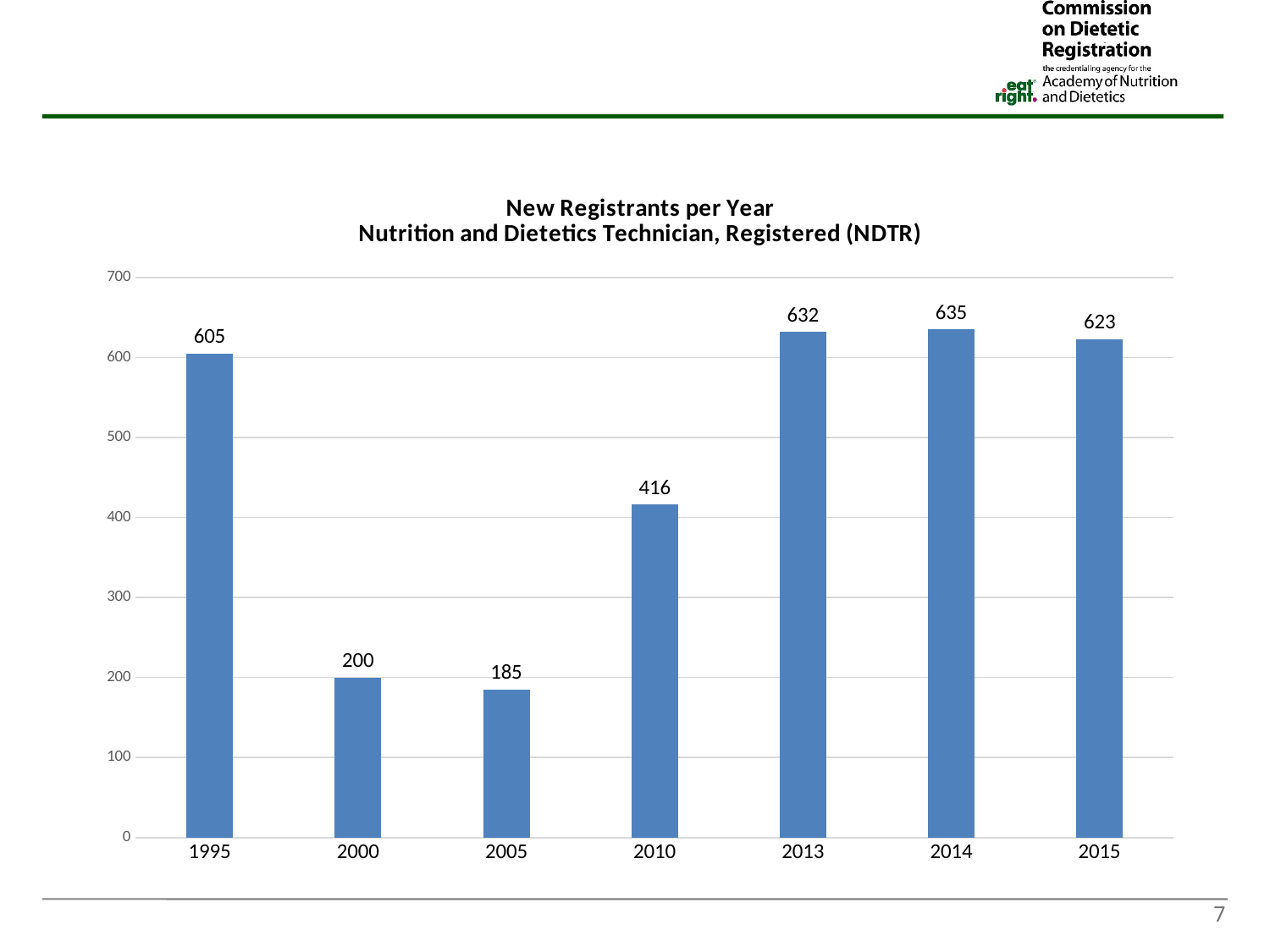
Which year had more new registrants, 2000 or 2005? 2000 How many years are shown on the x axis? 7 Do the values rise or fall from 2005 to 2013? Rise What is the difference between the number of new registrants in 2014 and in 2005? 450 Is the value for 2010 greater or less than 400? greater Which year has the lowest number of new registrants? 2005 What is the title of the chart? New Registrants per Year Nutrition and Dietetics Technician, Registered (NDTR) What is the difference between the number of new registrants in 2013 and in 2010? 216 What is the number of new NDTR registrants in 1995? 605 What kind of chart is shown on the slide? Bar chart Which year has the highest number of new registrants? 2014 What is the number of new NDTR registrants in 2010? 416